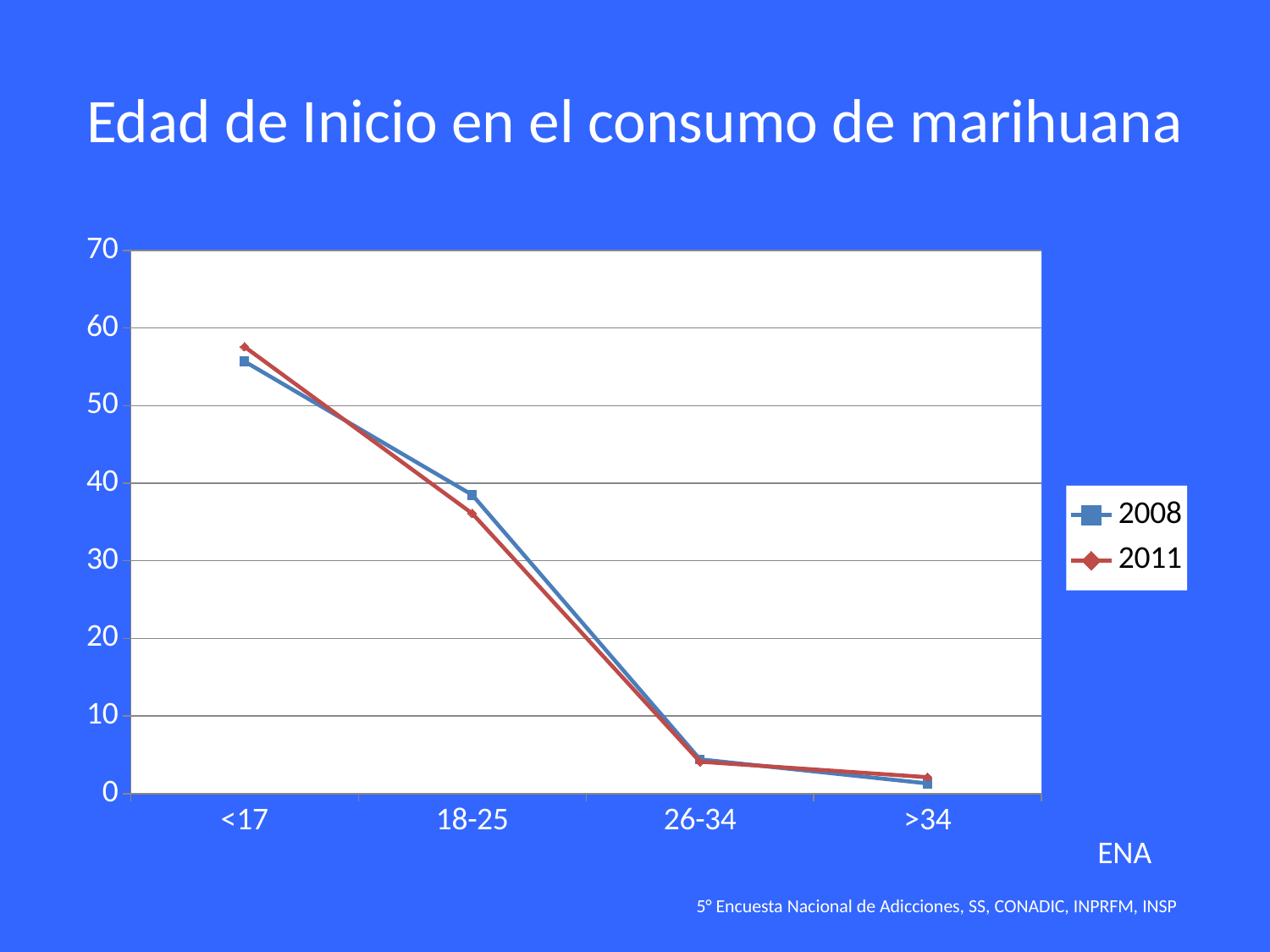
Is the value for 2011 at 18-25 greater or less than 40? less How many age categories are shown on the x axis? 4 Which age category has the lowest value for the 2011 series? >34 What is the title of the chart? Edad de Inicio en el consumo de marihuana What kind of chart is shown on the slide? line chart Is the value for 2008 at <17 greater or less than 50? greater At the 18-25 category, which series has the larger value, 2008 or 2011? 2008 Is the value for 2008 at 26-34 greater or less than 10? less Which age category has the highest value for the 2008 series? <17 How many series does the legend list? 2 Do the values for the 2011 series rise or fall as you move from <17 to >34 along the x axis? fall Which series is drawn in red? 2011